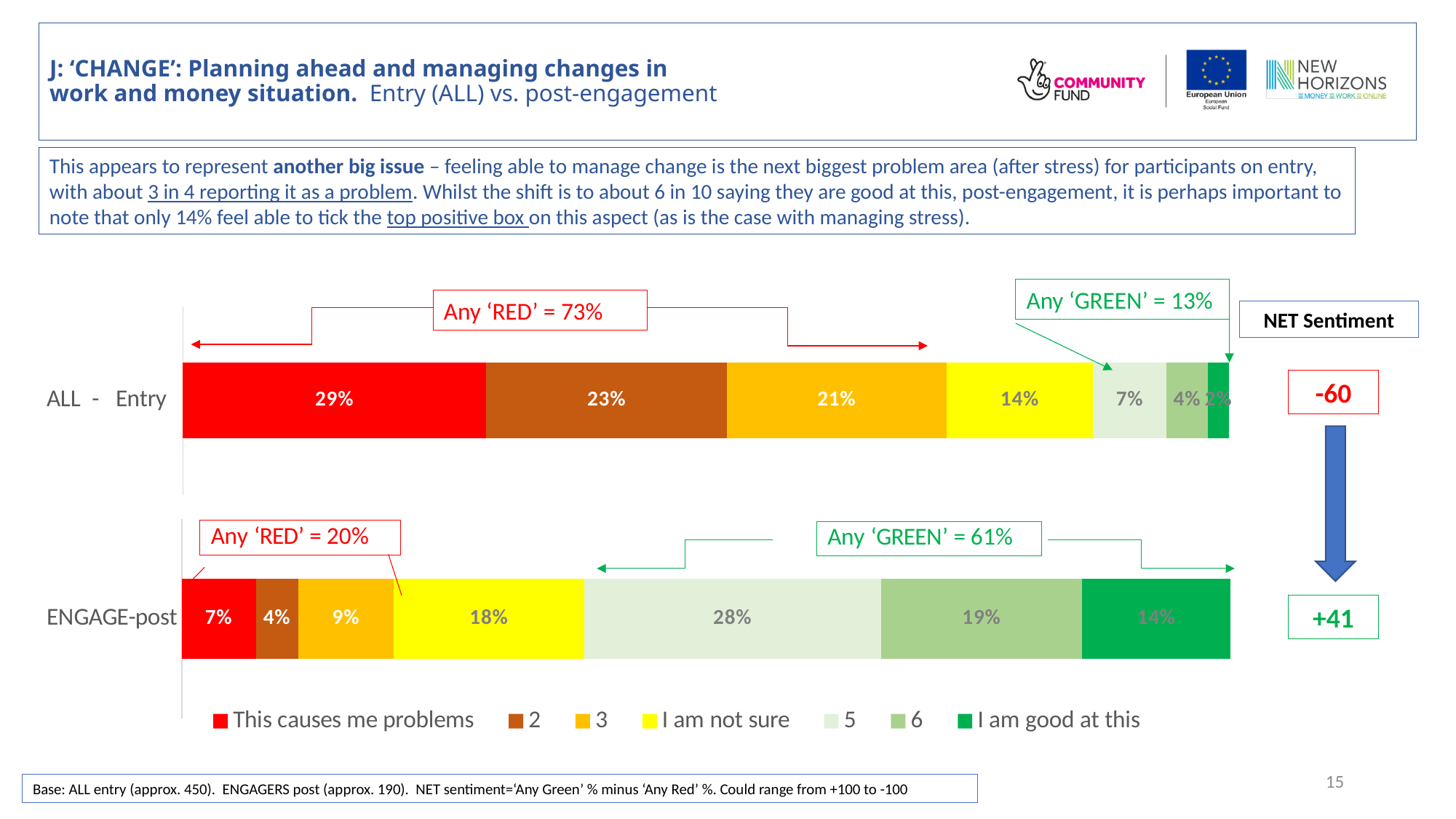
What type of chart is shown on the slide? Stacked bar chart How many series does the legend list? 7 What percentage of the ENGAGE-post bar is 'I am good at this'? 14% What is the 'I am not sure' value for ENGAGE-post? 18% What is the difference between the 'This causes me problems' values for ALL - Entry and ENGAGE-post? 22 percentage points Which is larger: the series 3 value for ALL - Entry or for ENGAGE-post? ALL - Entry (21%) What percentage of the ALL - Entry bar is 'This causes me problems'? 29% Which segment is the smallest in the ALL - Entry bar? I am good at this (2%) How many bars (categories) are plotted in the chart? 2 What NET Sentiment value is shown for ENGAGE-post? +41 What is the value for series 5 in the ALL - Entry bar? 7% Which segment is the largest in the ENGAGE-post bar? 5 (28%)